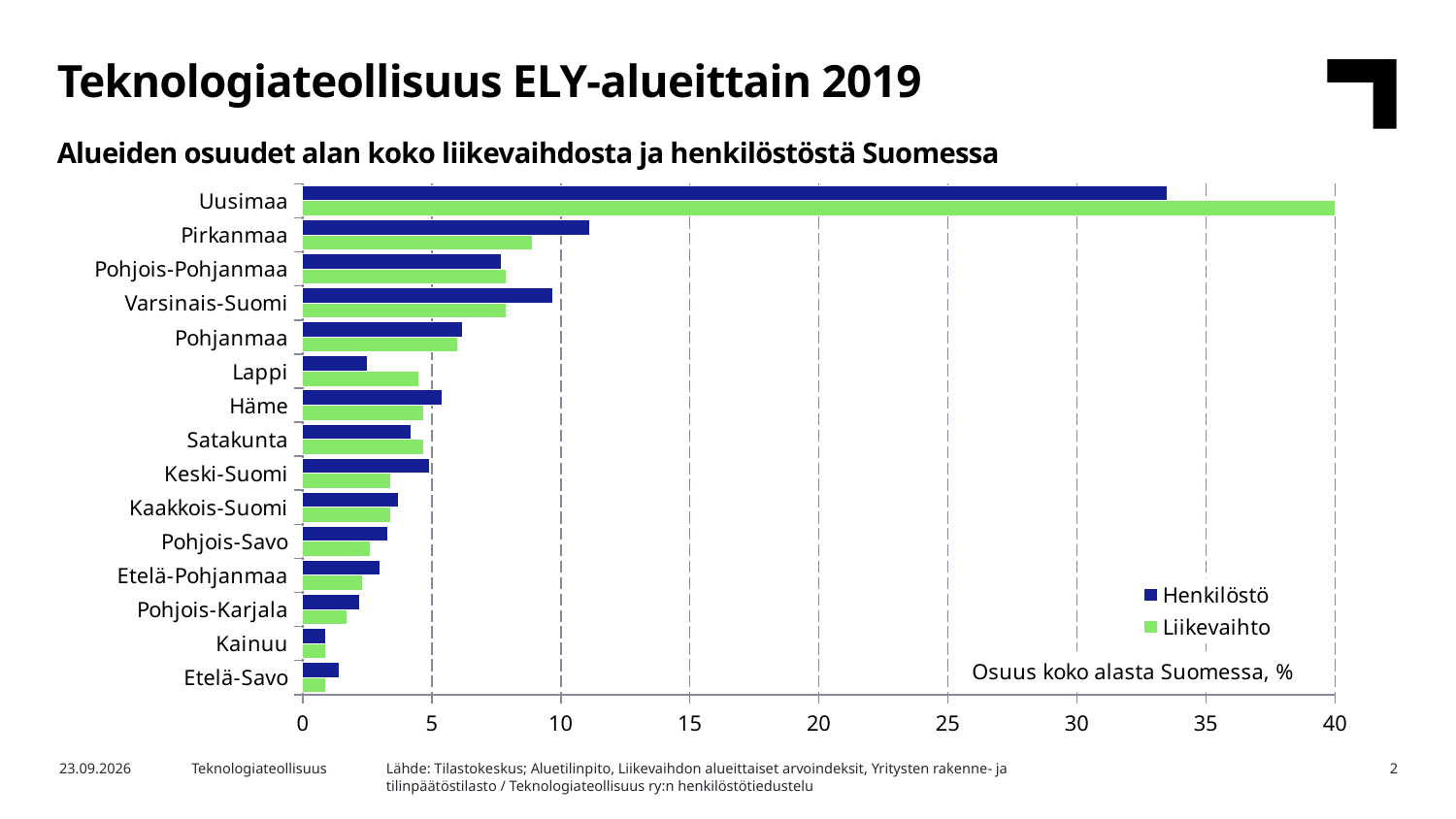
Which region has the lowest Henkilöstö share? Kainuu Is the Liikevaihto value for Lappi greater or less than 5? less Is the Henkilöstö value for Uusimaa greater or less than 30? greater How many series does the legend list? 2 What kind of chart is shown on the slide? Bar chart Which region has the highest Liikevaihto share? Uusimaa How many regions (categories) are shown on the chart? 15 For Varsinais-Suomi, which is larger: the Henkilöstö share or the Liikevaihto share? Henkilöstö Which region has the highest Henkilöstö share? Uusimaa Is the Liikevaihto value for Uusimaa greater or less than 35? greater Which series is shown in green in the legend? Liikevaihto